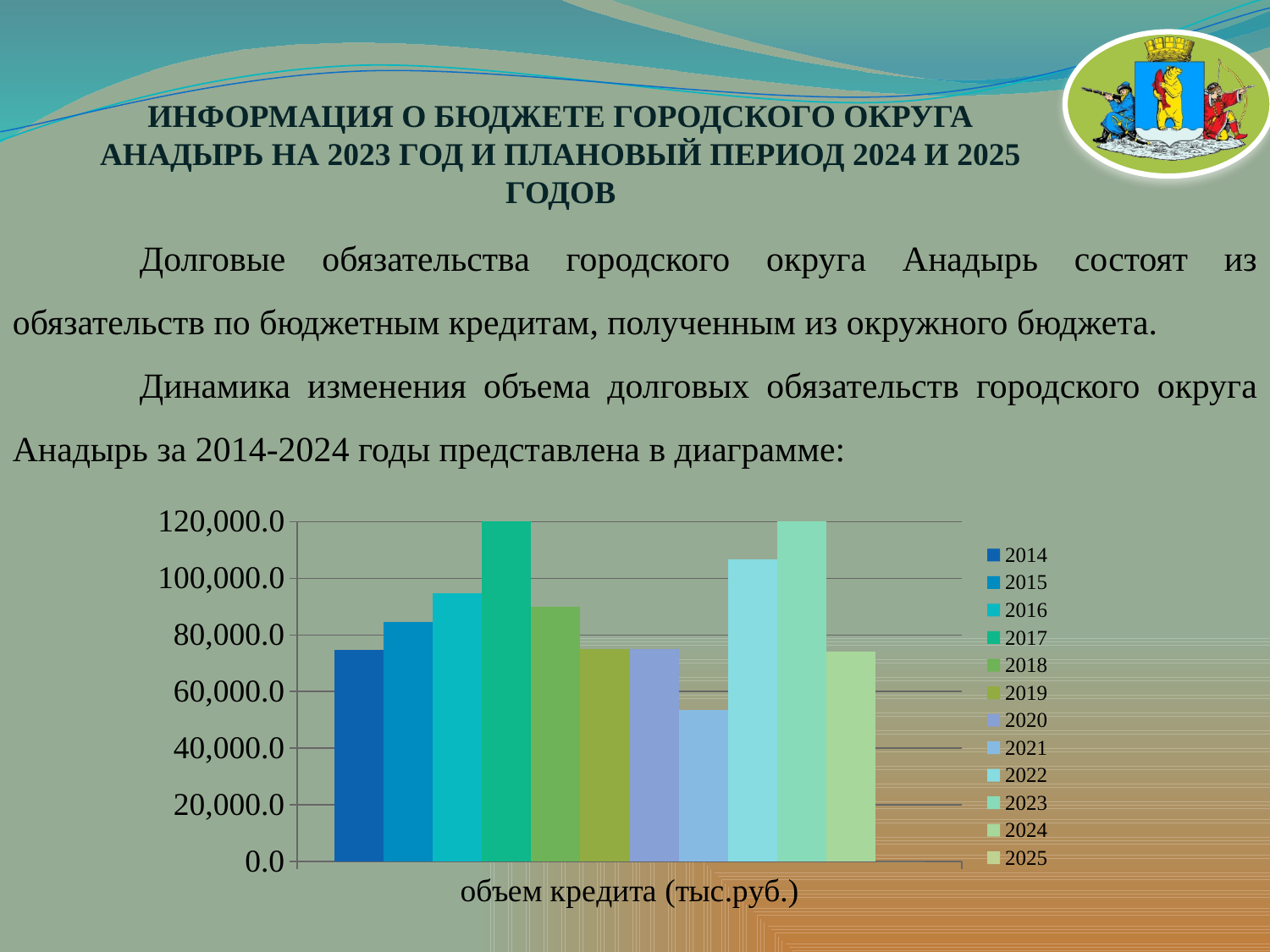
What is the highest tick value shown on the vertical axis? 120,000.0 Which is larger, the value for 2022 or the value for 2021? 2022 How many series does the chart legend list? 12 Is the value for 2014 greater or less than 80,000.0? less Is the value for 2018 greater or less than 100,000.0? less Is the value for 2022 greater or less than 100,000.0? greater What is the label shown on the horizontal axis of the chart? объем кредита (тыс.руб.) Which is larger, the value for 2016 or the value for 2014? 2016 What kind of chart is shown on the slide? bar chart